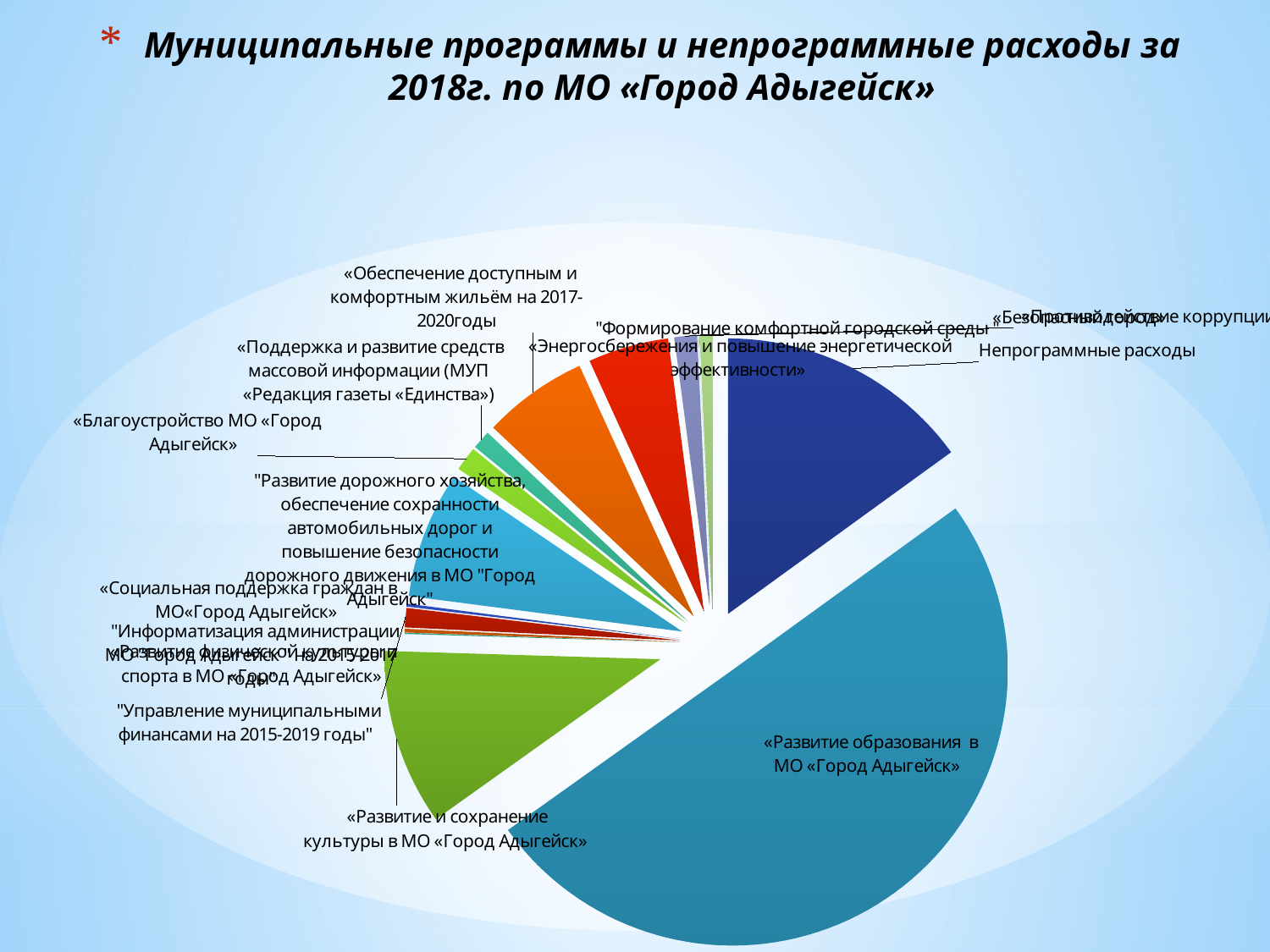
Which year do the expenditures shown in the chart refer to? 2018 Which slice is larger: «Развитие образования в МО «Город Адыгейск»» or Непрограммные расходы? «Развитие образования в МО «Город Адыгейск»» What is the title of the slide? Муниципальные программы и непрограммные расходы за 2018г. по МО «Город Адыгейск» What kind of chart is shown on the slide? pie chart Which slice is larger: "Развитие дорожного хозяйства, обеспечение сохранности автомобильных дорог и повышение безопасности дорожного движения в МО "Город Адыгейск"" or «Поддержка и развитие средств массовой информации (МУП «Редакция газеты «Единства»)»? "Развитие дорожного хозяйства, обеспечение сохранности автомобильных дорог и повышение безопасности дорожного движения в МО "Город Адыгейск"" Which category has the largest slice of the pie? «Развитие образования в МО «Город Адыгейск»» Which slice is larger: «Развитие образования в МО «Город Адыгейск»» or «Развитие и сохранение культуры в МО «Город Адыгейск»»? «Развитие образования в МО «Город Адыгейск»»